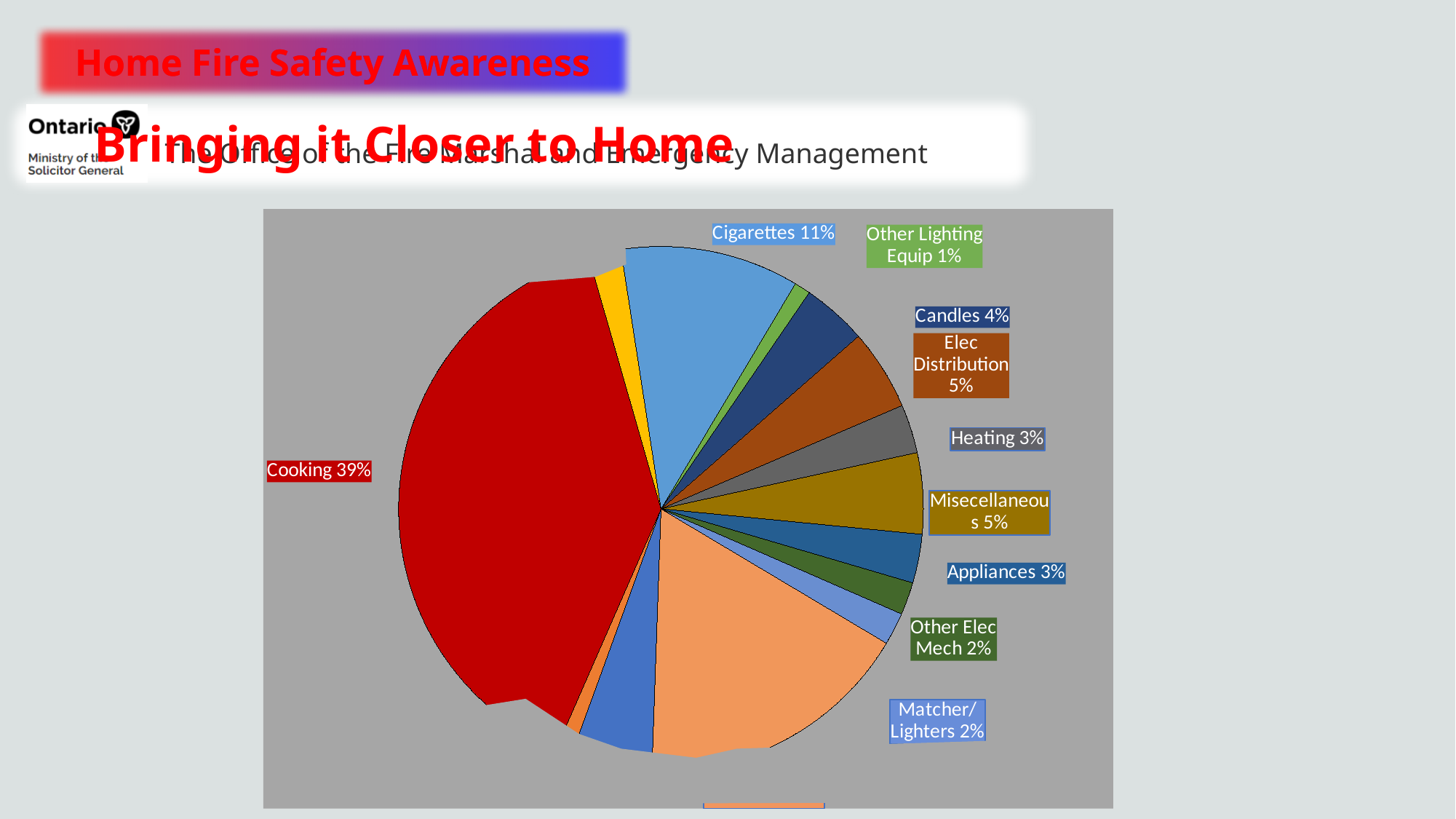
How many percentage points larger is Cooking than Cigarettes? 28 What percentage is shown for Elec Distribution? 5% What percentage is shown for Cigarettes? 11% What percentage is shown for Heating? 3% What colour is the Cooking slice? red Which labelled category has the largest share of the pie? Cooking Which labelled category has the smallest share of the pie? Other Lighting Equip What share of the pie does Cooking account for? 39% What percentage is shown for Candles? 4% What kind of chart is shown on the slide? pie chart What percentage is shown for Other Lighting Equip? 1% Which is larger, Candles or Heating? Candles